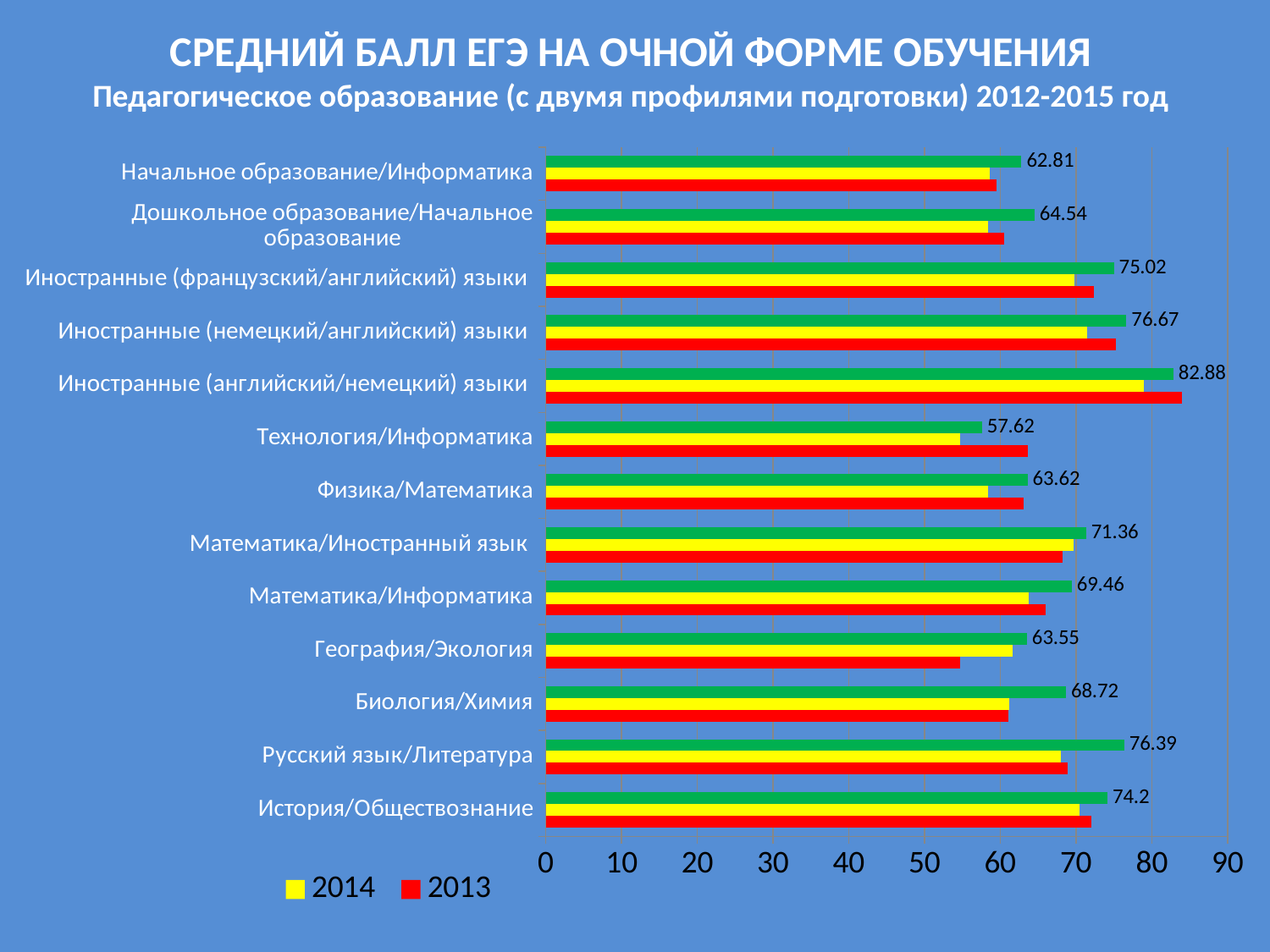
Which has the larger labelled value: История/Обществознание or Биология/Химия? История/Обществознание How many categories are shown on the chart? 13 What is the difference between the labelled values for Иностранные (английский/немецкий) языки and Технология/Информатика? 25.26 Which category has the lowest labelled value on the green bars? Технология/Информатика Is the 2013 (red) bar for География/Экология greater or less than 60? less What is the labelled value of the green bar for Физика/Математика? 63.62 What is the difference between the labelled values for Русский язык/Литература and История/Обществознание? 2.19 What is the labelled value of the green bar for Иностранные (английский/немецкий) языки? 82.88 Which category has the highest labelled value on the green bars? Иностранные (английский/немецкий) языки Is the 2013 (red) bar for Иностранные (английский/немецкий) языки greater or less than 80? greater How many series does the legend list? 2 What kind of chart is shown on the slide? Bar chart